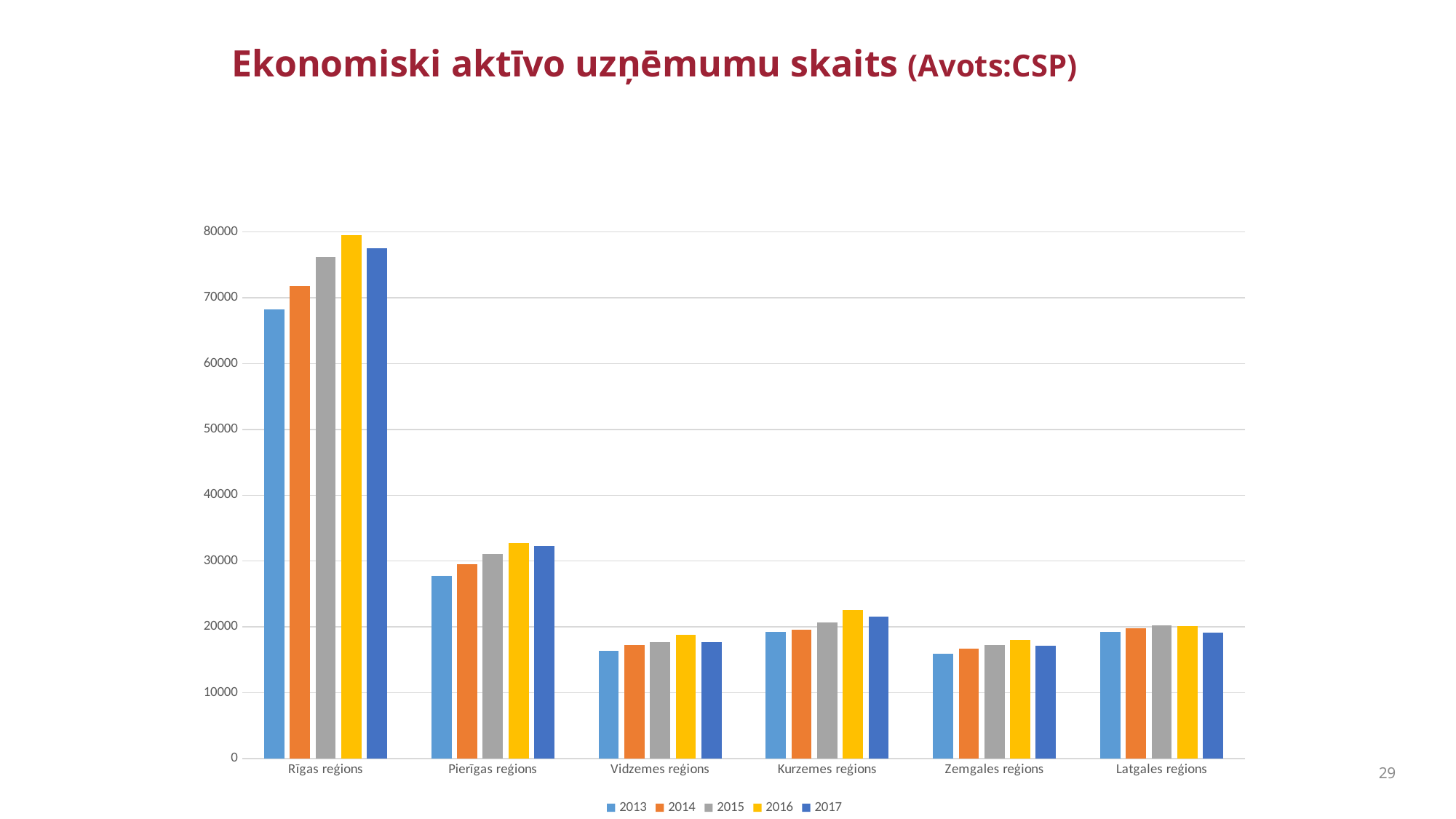
How many regions are shown on the x axis? 6 What kind of chart is shown on the slide? bar chart Do the values for Rīgas reģions rise or fall from 2013 to 2016? rise Which colour represents 2016 in the legend? yellow For Rīgas reģions, which year has the highest bar? 2016 How many series does the legend list? 5 Is the value for Rīgas reģions in 2013 greater or less than 70000? less Is the value for Pierīgas reģions in 2016 greater or less than 30000? greater Which region has the highest value for 2016? Rīgas reģions Is the value for Zemgales reģions in 2013 greater or less than 20000? less For Rīgas reģions, which year has the lowest bar? 2013 Which is larger in 2016: Kurzemes reģions or Latgales reģions? Kurzemes reģions